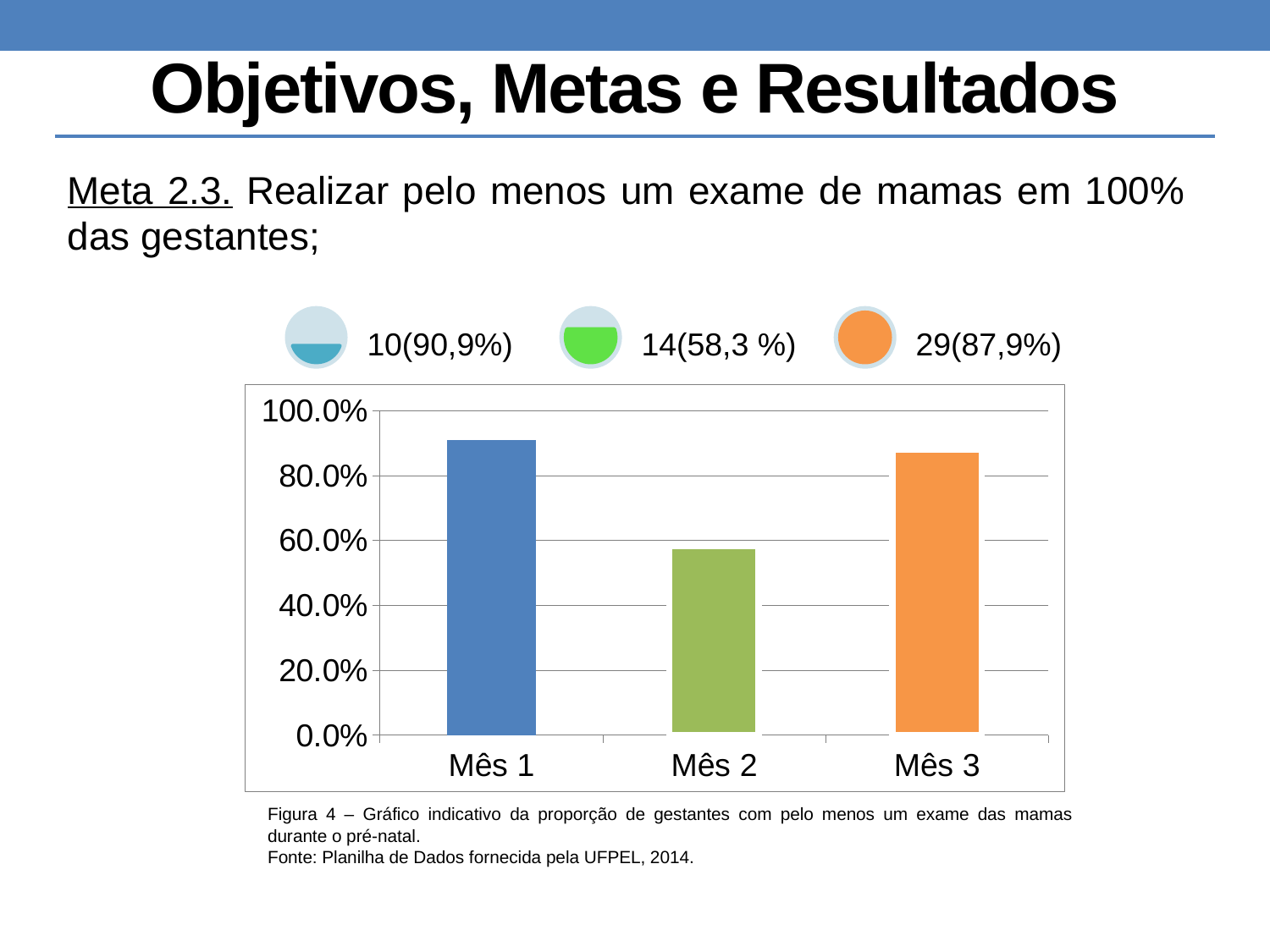
According to the label above the chart, what percentage is shown for the blue series (Mês 1)? 90,9% Is the value for Mês 2 greater or less than 40.0%? greater Which month has the lowest bar in the chart? Mês 2 Is the value for Mês 2 greater or less than 80.0%? less Is the value for Mês 3 greater or less than 100.0%? less What colour is the bar for Mês 2? green Which is larger, the value for Mês 2 or the value for Mês 3? Mês 3 Which month has the highest bar in the chart? Mês 1 What kind of chart is shown on the slide? bar chart How many categories (months) are shown on the x axis of the chart? 3 According to the label above the chart, what percentage is shown for the orange series (Mês 3)? 87,9%